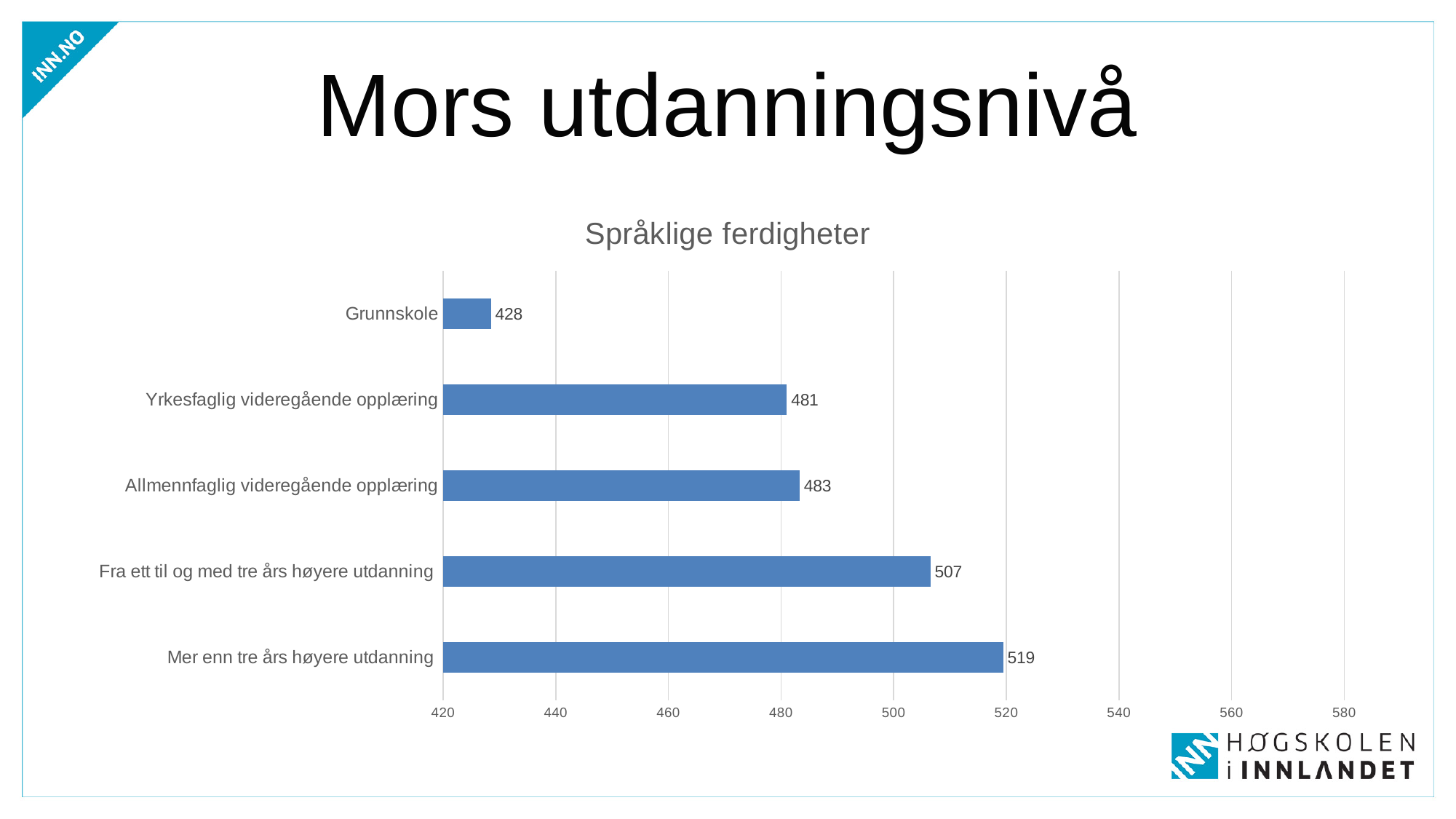
What is the value for Fra ett til og med tre års høyere utdanning? 507 What is the difference between the values for Mer enn tre års høyere utdanning and Grunnskole? 91 Which category has the highest value? Mer enn tre års høyere utdanning What is the value for Mer enn tre års høyere utdanning? 519 What is the difference between the values for Allmennfaglig videregående opplæring and Yrkesfaglig videregående opplæring? 2 What is the title of the chart? Språklige ferdigheter How many categories are shown in the chart? 5 What is the value for Grunnskole? 428 Which category has the lowest value? Grunnskole What kind of chart is shown on the slide? Bar chart Which is larger: the value for Fra ett til og med tre års høyere utdanning or the value for Allmennfaglig videregående opplæring? Fra ett til og med tre års høyere utdanning What is the value for Yrkesfaglig videregående opplæring? 481